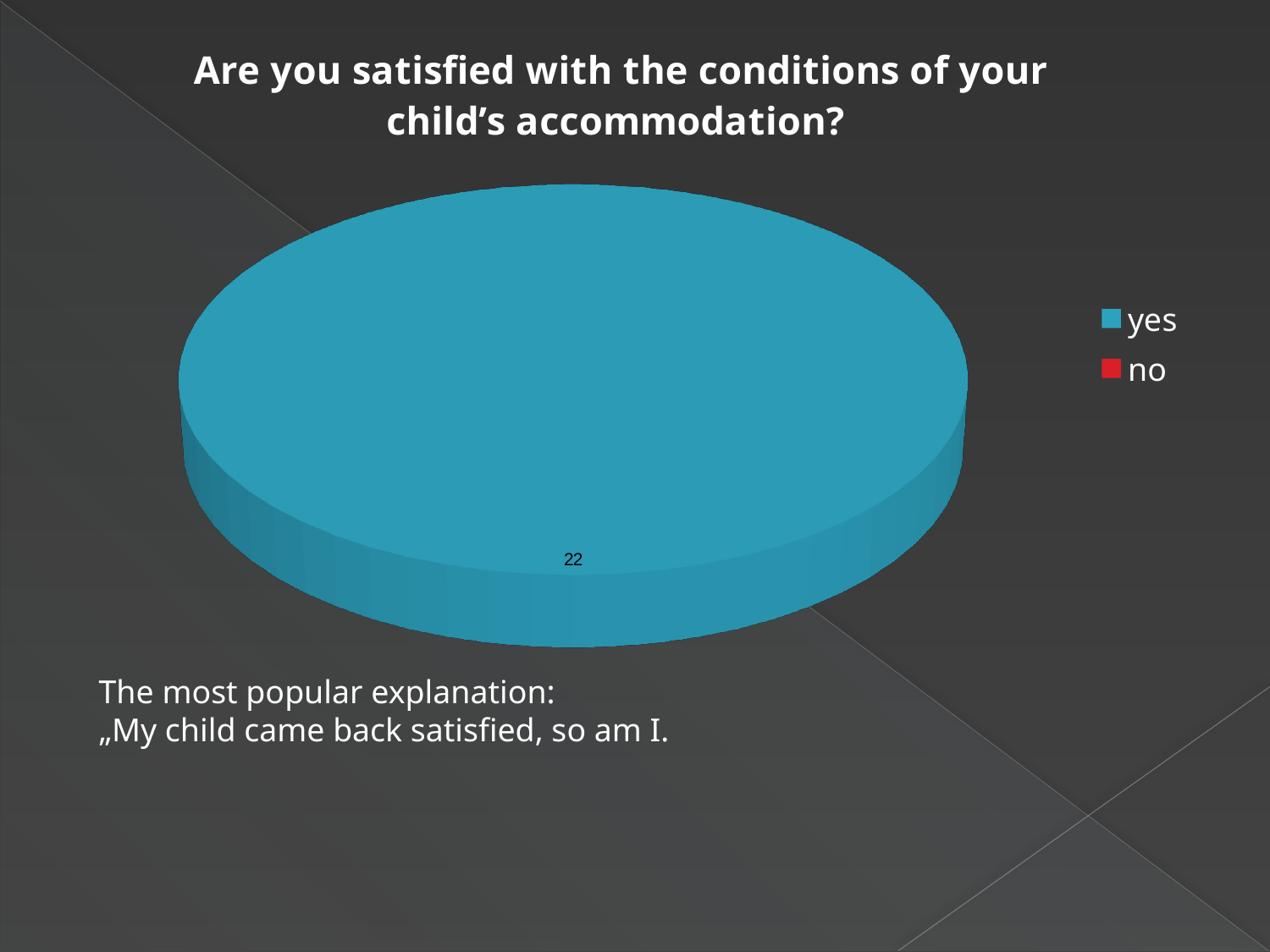
What colour represents "yes" in the legend? blue What is the value shown for the "yes" slice? 22 Which category takes up the largest part of the pie? yes Which is larger, the value for "yes" or the value for "no"? yes What is the title of the chart? Are you satisfied with the conditions of your child's accommodation? How many entries does the legend list? 2 Which category has the smallest share of the pie? no What kind of chart is shown on the slide? pie chart